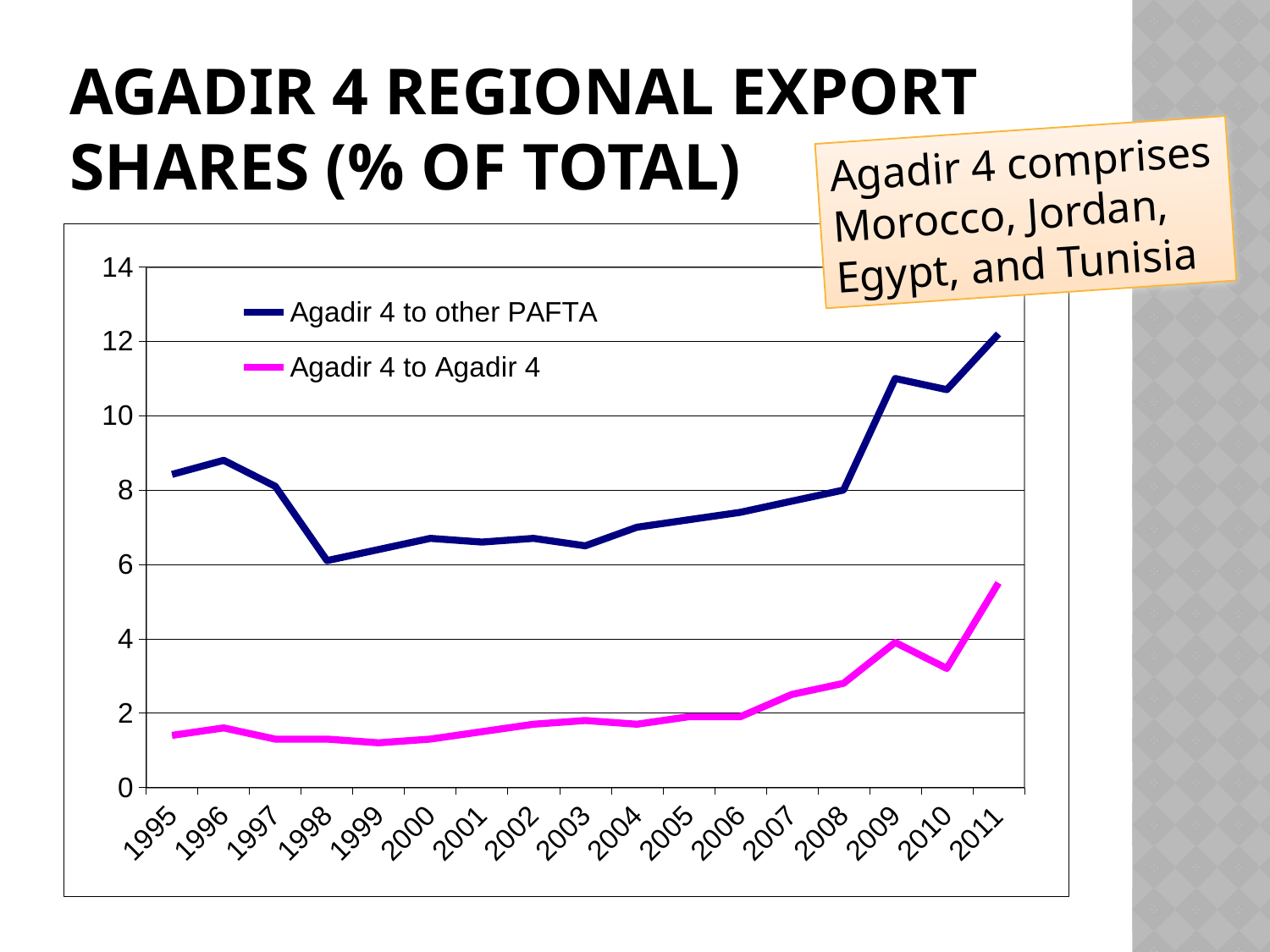
In which year is the value for Agadir 4 to other PAFTA lowest? 1998 What kind of chart is shown on the slide? line chart In which year is the value for Agadir 4 to other PAFTA highest? 2011 Is the value for Agadir 4 to Agadir 4 in 2010 greater or less than 4? less How many series does the legend list? 2 Is the value for Agadir 4 to other PAFTA in 1995 greater or less than 8? greater Is the value for Agadir 4 to other PAFTA in 2009 greater or less than 10? greater Which is larger for Agadir 4 to other PAFTA, the value in 1996 or the value in 1997? 1996 How many years are plotted along the x axis? 17 In which year is the value for Agadir 4 to Agadir 4 highest? 2011 Which series is drawn in magenta? Agadir 4 to Agadir 4 Does the Agadir 4 to Agadir 4 series generally rise or fall from 1995 to 2011? rise